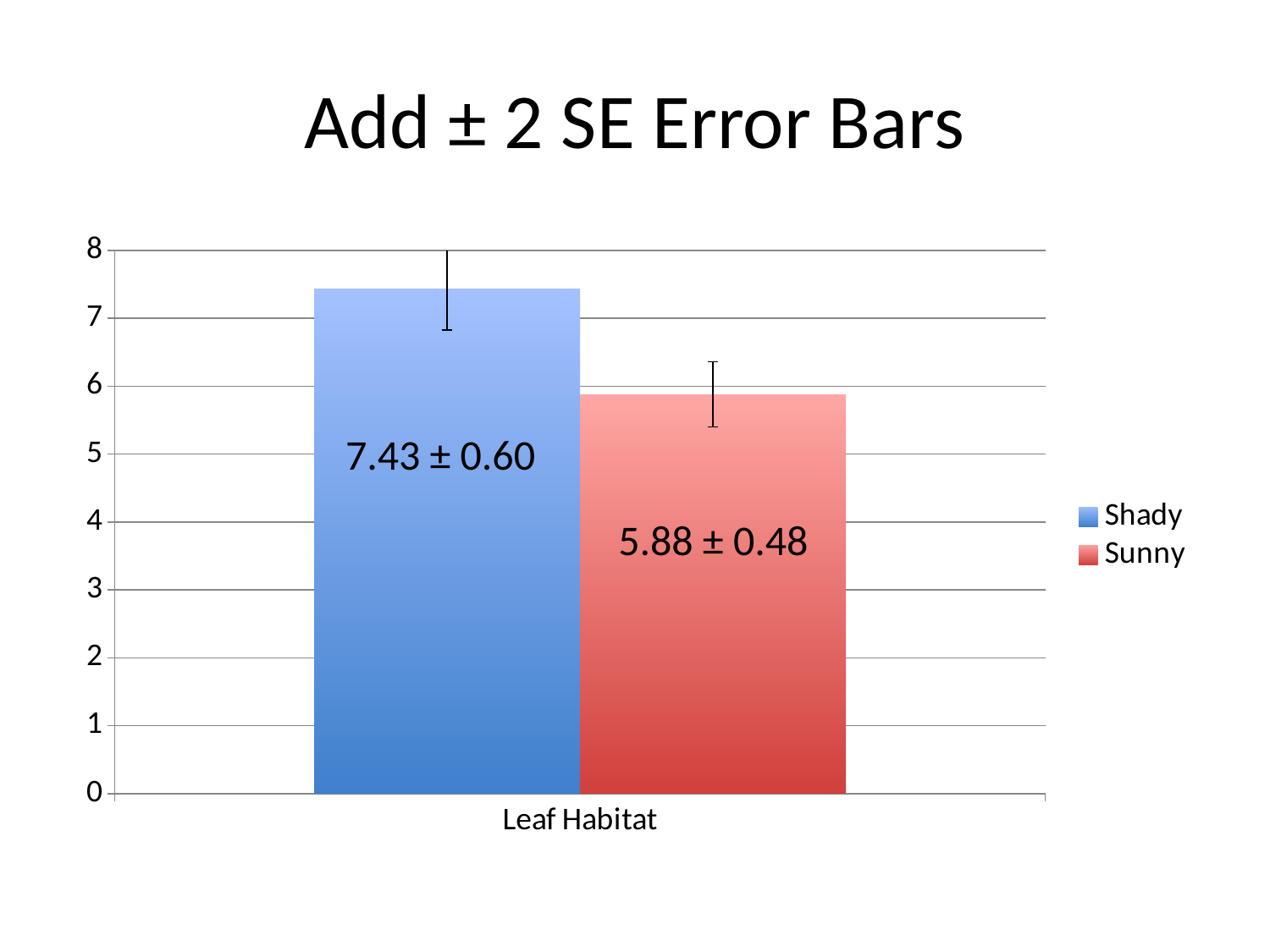
What is the value shown for Sunny? 5.88 ± 0.48 Is the value for Sunny greater or less than 6? less What is the value shown for Shady? 7.43 ± 0.60 What is the title of the slide? Add ± 2 SE Error Bars Which series has the lowest bar? Sunny Which series has the highest bar? Shady What kind of chart is shown on the slide? bar chart What is the label on the x axis? Leaf Habitat Is the value for Shady greater or less than 7? greater How many series does the legend list? 2 Which series has the higher bar, Shady or Sunny? Shady What is the difference between the Shady mean (7.43) and the Sunny mean (5.88)? 1.55